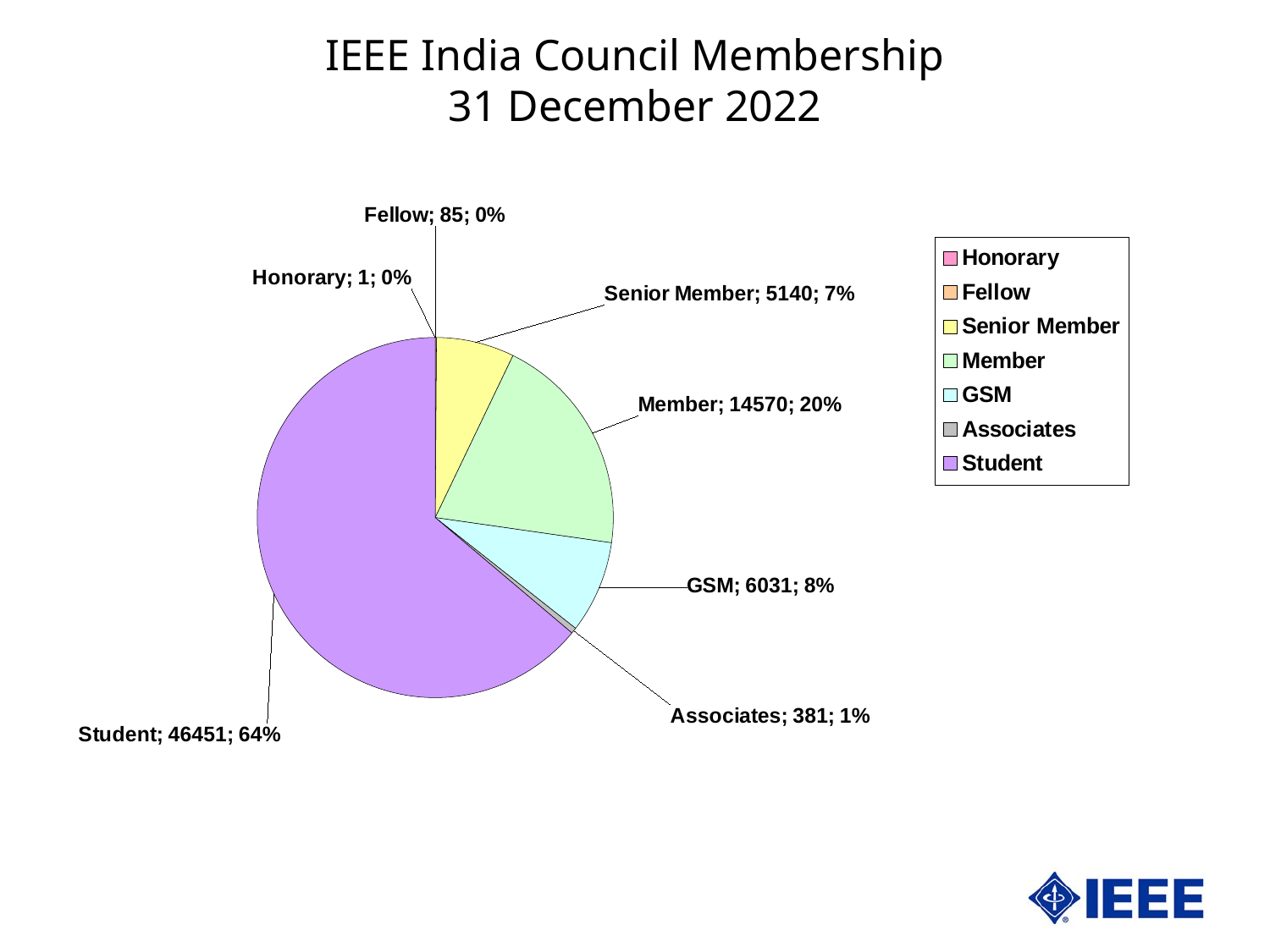
What is the value for GSM? 6031 How many members are in the Student category? 46451 What is the difference between the Member and Senior Member values? 9430 Which is larger, GSM or Senior Member? GSM What share of the pie does the Member category represent? 20% What share of the pie does Student represent? 64% How many categories does the pie chart have? 7 What kind of chart is shown on the slide? pie chart What is the title of the chart? IEEE India Council Membership 31 December 2022 Which category has the smallest value? Honorary What is the value for Senior Member? 5140 Which category has the largest slice? Student